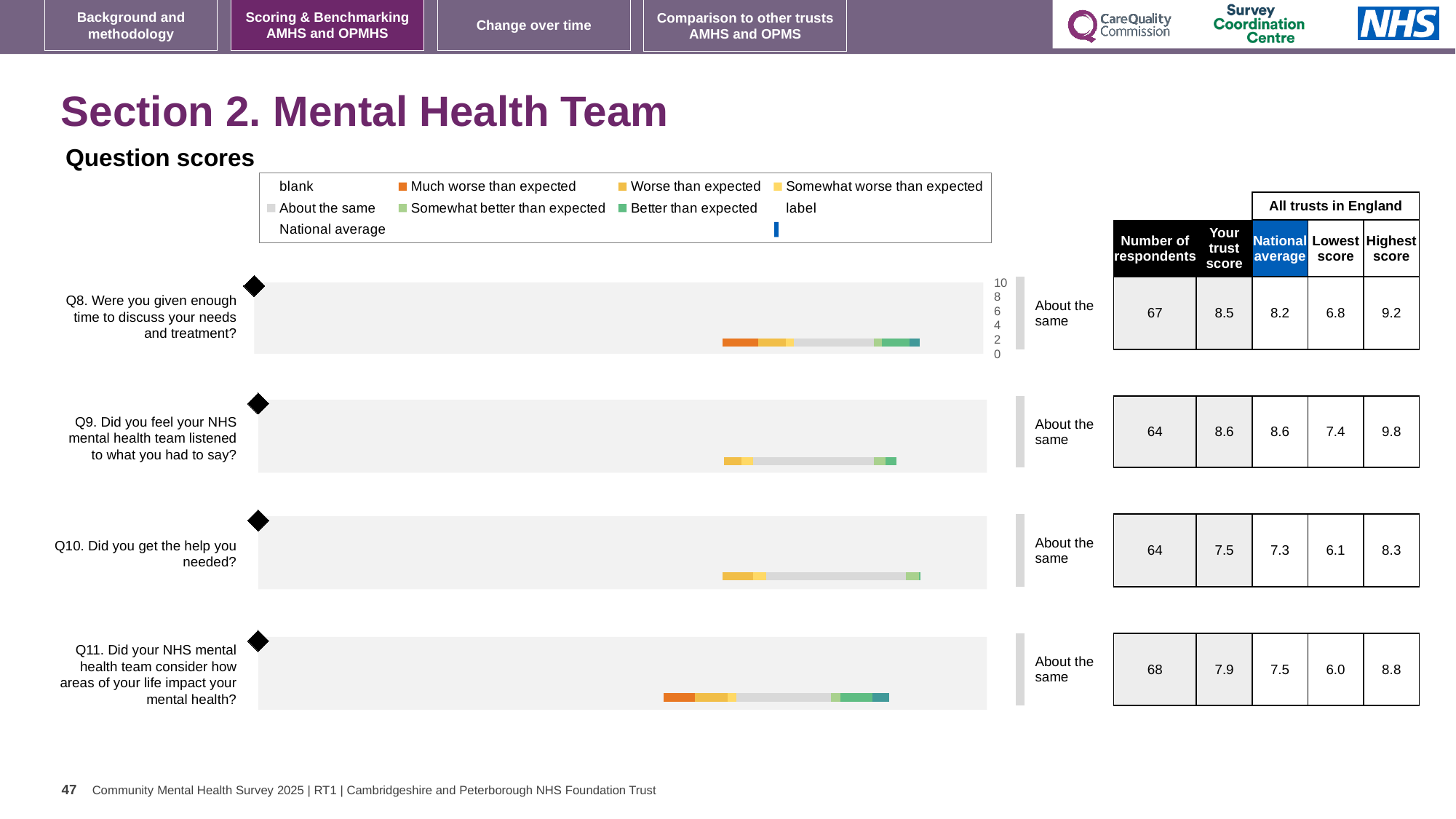
For Q11, what is the lowest score among all trusts in England? 6.0 What benchmark category is shown next to the Q10 chart? About the same For Q8 (Were you given enough time to discuss your needs and treatment?), what is the number of respondents? 67 Which question has the highest 'Your trust score'? Q9 Which question has the lowest 'Your trust score'? Q10 For Q11 (Did your NHS mental health team consider how areas of your life impact your mental health?), what is the highest score among all trusts in England? 8.8 For Q11, what is the difference between your trust score and the national average? 0.4 For Q10 (Did you get the help you needed?), what is the national average? 7.3 For Q8, which is larger: your trust score or the national average? Your trust score For Q9 (Did you feel your NHS mental health team listened to what you had to say?), what is your trust score? 8.6 What kind of chart is used for each question on the slide? Bar chart How many question charts are shown on the slide? 4